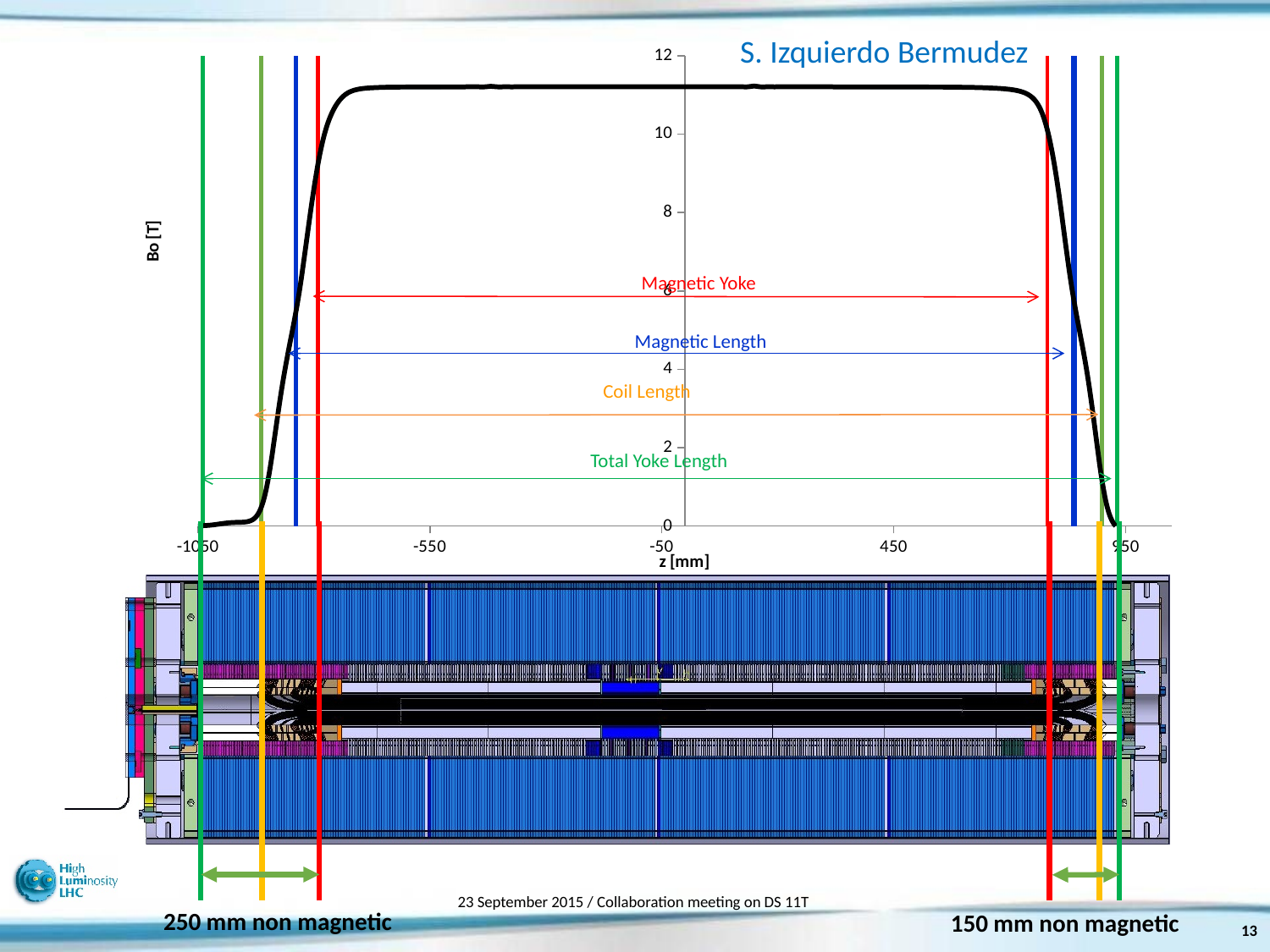
Which is larger, the value of Bo at z = -50 mm or at z = 950 mm? z = -50 mm What is the label of the vertical axis of the chart? Bo [T] What kind of chart is shown on the slide? line chart Does the value of Bo rise or fall as z goes from 450 mm to 950 mm? fall Is the value of Bo at z = -550 mm greater or less than 8? greater Is the value of Bo at z = 450 mm greater or less than 10? greater Is the value of Bo at z = -50 mm greater or less than 10? greater Does the value of Bo rise or fall as z goes from -1050 mm to -550 mm? rise What is the label of the horizontal axis of the chart? z [mm]